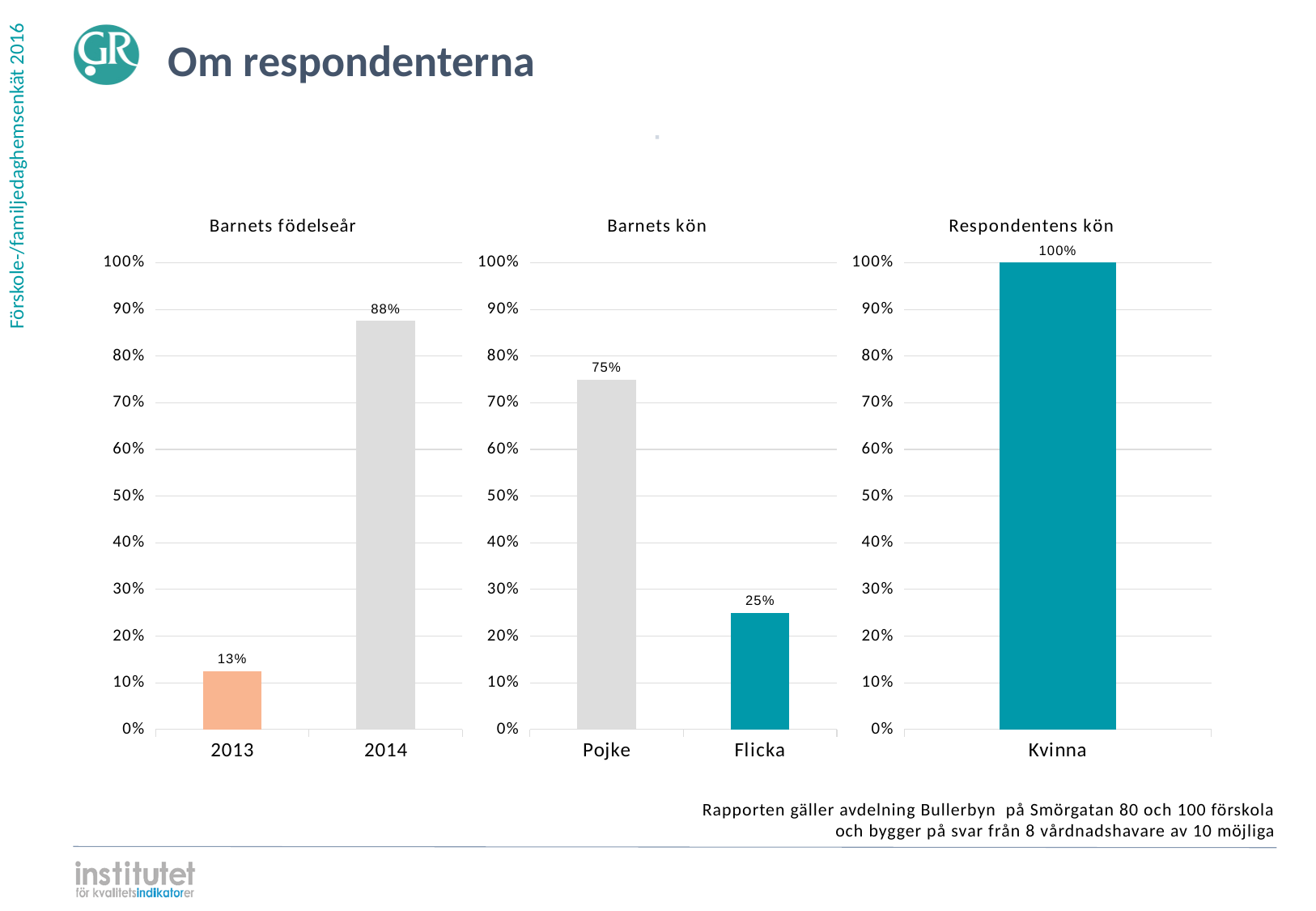
In the 'Barnets kön' chart, what is the value for Pojke? 75% How many categories are shown in the 'Barnets kön' chart? 2 In the 'Respondentens kön' chart, what is the value for Kvinna? 100% In the 'Barnets kön' chart, what is the difference between the values for Pojke and Flicka? 50% In the 'Barnets kön' chart, which category has the lowest value? Flicka In the 'Barnets födelseår' chart, what is the value for 2013? 13% In the 'Barnets födelseår' chart, which category has the highest value? 2014 In the 'Barnets födelseår' chart, what is the difference between the values for 2014 and 2013? 75% In the 'Barnets kön' chart, what is the value for Flicka? 25% In the 'Barnets födelseår' chart, what is the value for 2014? 88% In the 'Barnets födelseår' chart, is the value for 2013 greater or less than 20%? less What kind of chart is the 'Respondentens kön' chart? bar chart